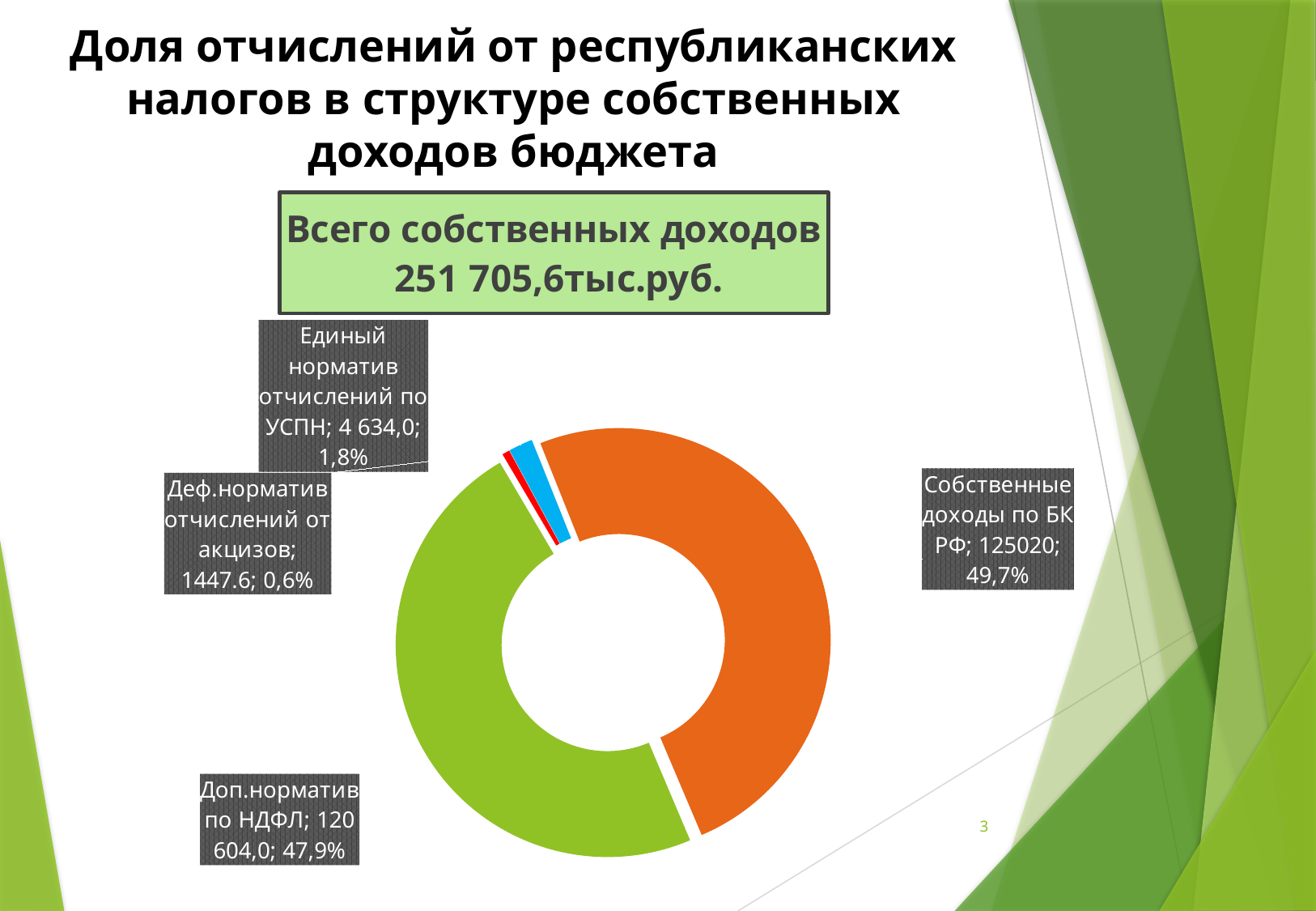
How many slices does the doughnut chart have? 4 Which category has the smallest share of the doughnut? Деф.норматив отчислений от акцизов What share of the doughnut does "Собственные доходы по БК РФ" represent? 49,7% What is the value shown for "Единый норматив отчислений по УСПН"? 4 634,0 What share of the doughnut does "Доп.норматив по НДФЛ" represent? 47,9% What is the value shown for "Доп.норматив по НДФЛ"? 120 604,0 What kind of chart is shown on the slide? Doughnut (pie) chart What is the value shown for "Собственные доходы по БК РФ"? 125020 What total of own revenues is stated in the green box above the chart? 251 705,6тыс.руб. What share of the doughnut does "Деф.норматив отчислений от акцизов" represent? 0,6% What is the difference in percentage points between the shares of "Единый норматив отчислений по УСПН" and "Деф.норматив отчислений от акцизов"? 1,2% Which category has the largest share of the doughnut? Собственные доходы по БК РФ